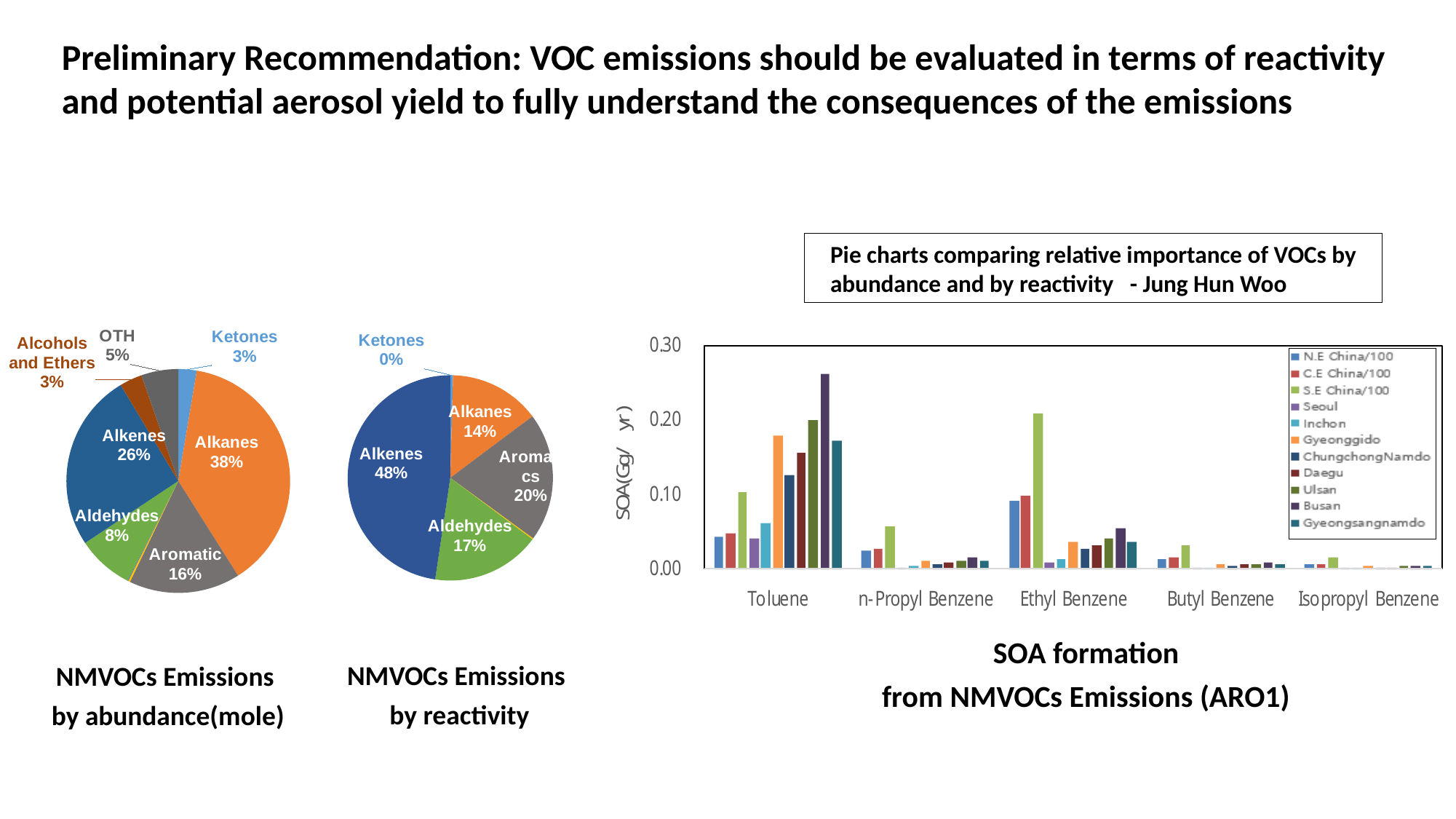
How many series does the legend of the 'SOA formation from NMVOCs Emissions (ARO1)' chart list? 11 In the pie chart 'NMVOCs Emissions by abundance(mole)', what is the difference between the Alkenes share and the Aldehydes share? 18% What kind of chart is 'SOA formation from NMVOCs Emissions (ARO1)'? Bar chart How many categories are shown in the pie chart 'NMVOCs Emissions by abundance(mole)'? 7 In the 'SOA formation from NMVOCs Emissions (ARO1)' chart, which series has the highest value for Toluene? Busan In the pie chart 'NMVOCs Emissions by reactivity', what share do Alkenes have? 48% Which is larger: the Aromatic share in the 'by abundance(mole)' pie chart or the Aromatics share in the 'by reactivity' pie chart? by reactivity (20%) In the pie chart 'NMVOCs Emissions by reactivity', which category has the smallest share? Ketones In the 'SOA formation from NMVOCs Emissions (ARO1)' chart, is the value for S.E China/100 at Ethyl Benzene greater or less than 0.20? greater In the pie chart 'NMVOCs Emissions by abundance(mole)', what share do Alkanes have? 38% In the pie chart 'NMVOCs Emissions by reactivity', what share do Aldehydes have? 17% In the pie chart 'NMVOCs Emissions by abundance(mole)', which category has the largest share? Alkanes